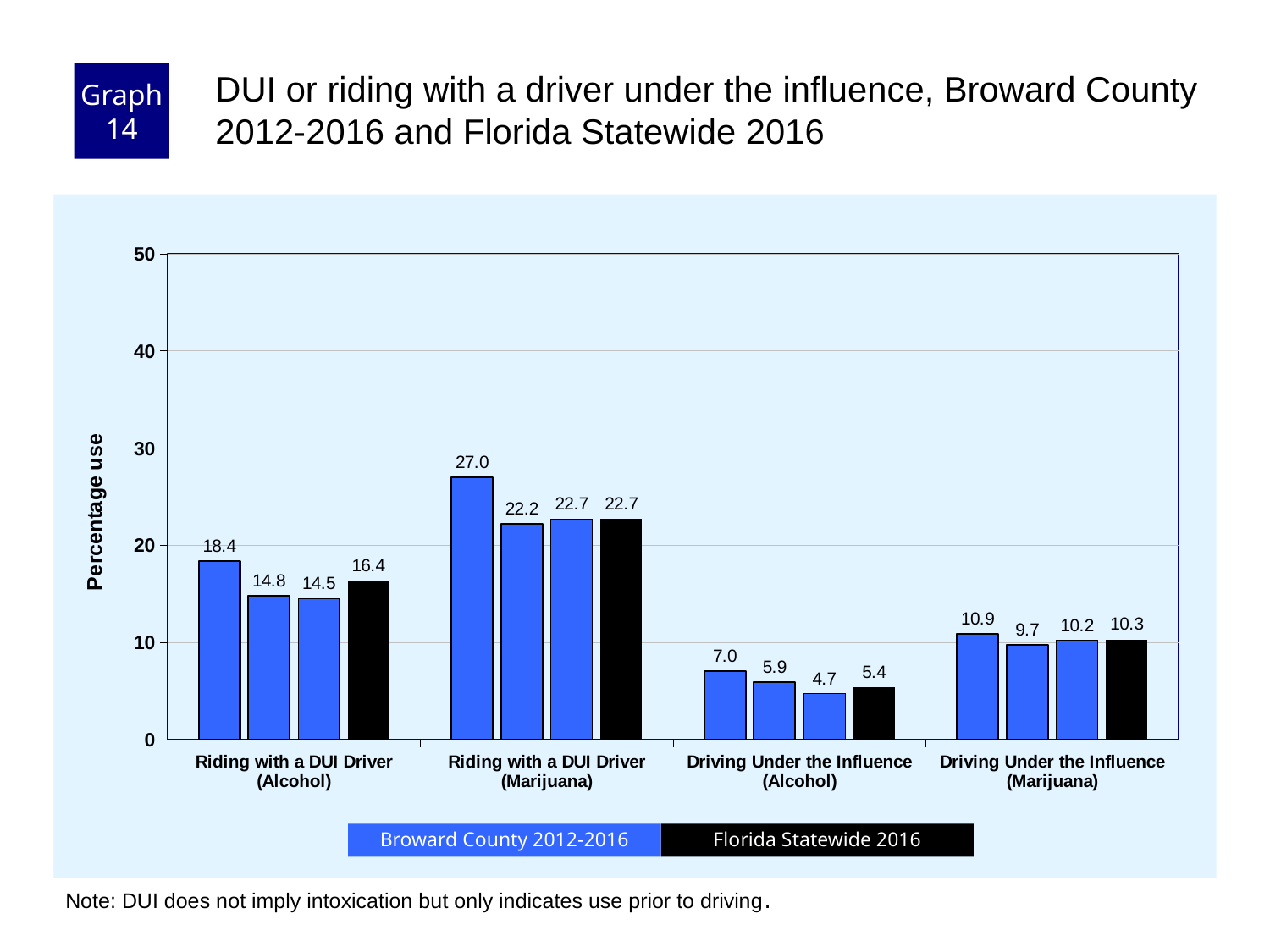
Which category contains the shortest bar on the chart? Driving Under the Influence (Alcohol) Is the tallest bar in Riding with a DUI Driver (Marijuana) greater or less than 30? less What is the value of the first (leftmost) Broward County bar for Driving Under the Influence (Alcohol)? 7.0 What is the Florida Statewide 2016 value for Riding with a DUI Driver (Marijuana)? 22.7 What is the difference between the first Broward County bar (18.4) and the Florida Statewide 2016 bar for Riding with a DUI Driver (Alcohol)? 2.0 What is the Florida Statewide 2016 value for Driving Under the Influence (Alcohol)? 5.4 What is the difference between the Florida Statewide 2016 values for Driving Under the Influence (Marijuana) and Driving Under the Influence (Alcohol)? 4.9 How many categories are shown on the x axis? 4 Which has the larger Florida Statewide 2016 value: Riding with a DUI Driver (Alcohol) or Driving Under the Influence (Marijuana)? Riding with a DUI Driver (Alcohol) How many series does the legend list? 2 What kind of chart is shown on the slide? bar chart Which category contains the tallest bar on the chart? Riding with a DUI Driver (Marijuana)